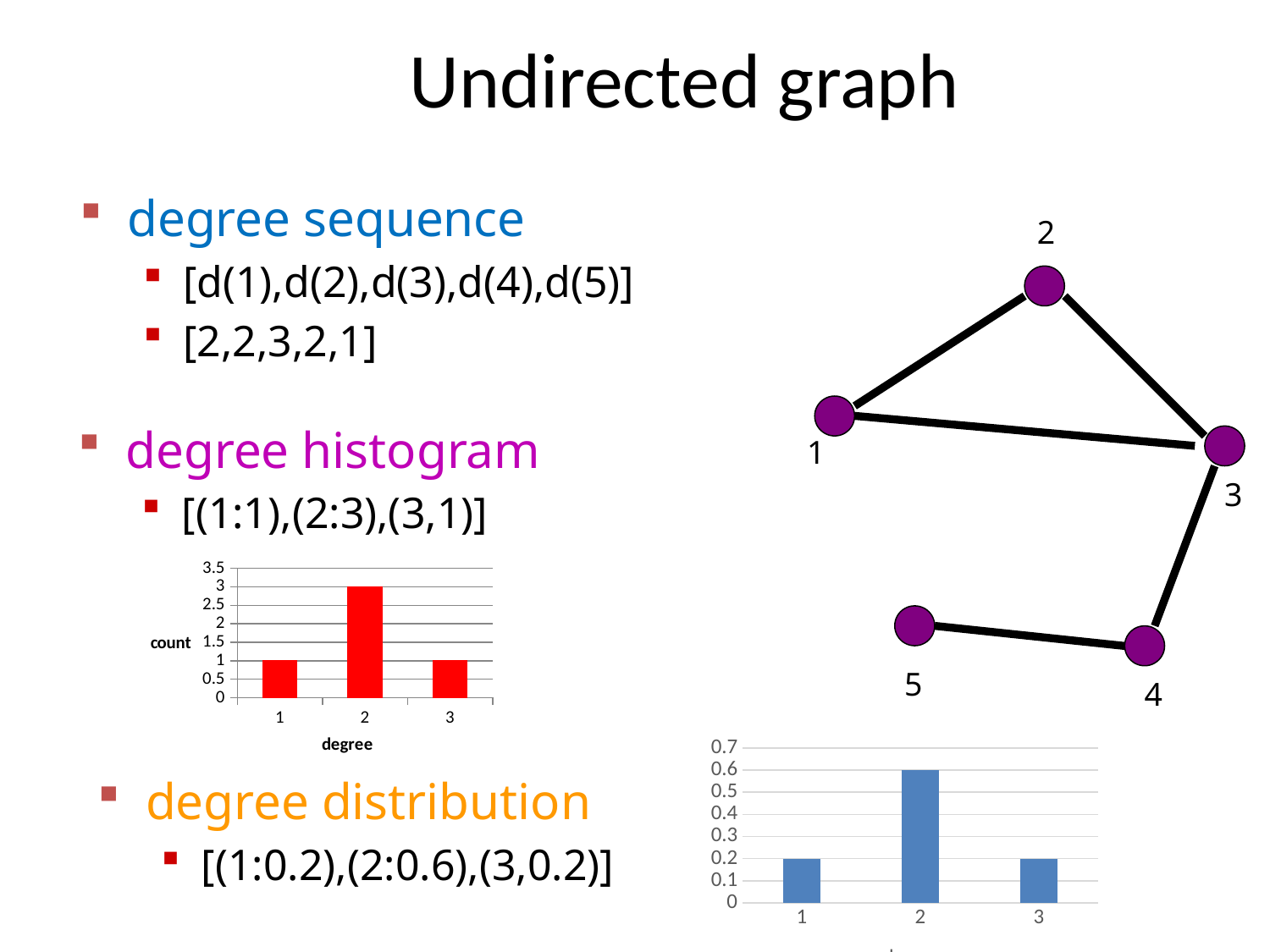
In the degree histogram chart on the left, what is the count for degree 2? 3 In the degree histogram chart on the left, what is the difference between the count for degree 2 and the count for degree 3? 2 In the degree distribution chart at the bottom right, is the value for category 2 greater or less than 0.5? greater In the degree distribution chart at the bottom right, what is the value for degree 2? 0.6 In the degree distribution chart at the bottom right, what is the value for degree 3? 0.2 In the degree distribution chart at the bottom right, what is the difference between the values for categories 2 and 1? 0.4 In the degree histogram chart on the left, what is the label of the vertical axis? count In the degree histogram chart on the left, which degree has the highest count? 2 In the degree histogram chart on the left, how many bars are plotted? 3 In the degree histogram chart on the left, what is the count for degree 1? 1 What kind of chart is the degree histogram on the left? bar chart In the degree distribution chart at the bottom right, which category has the highest value? 2